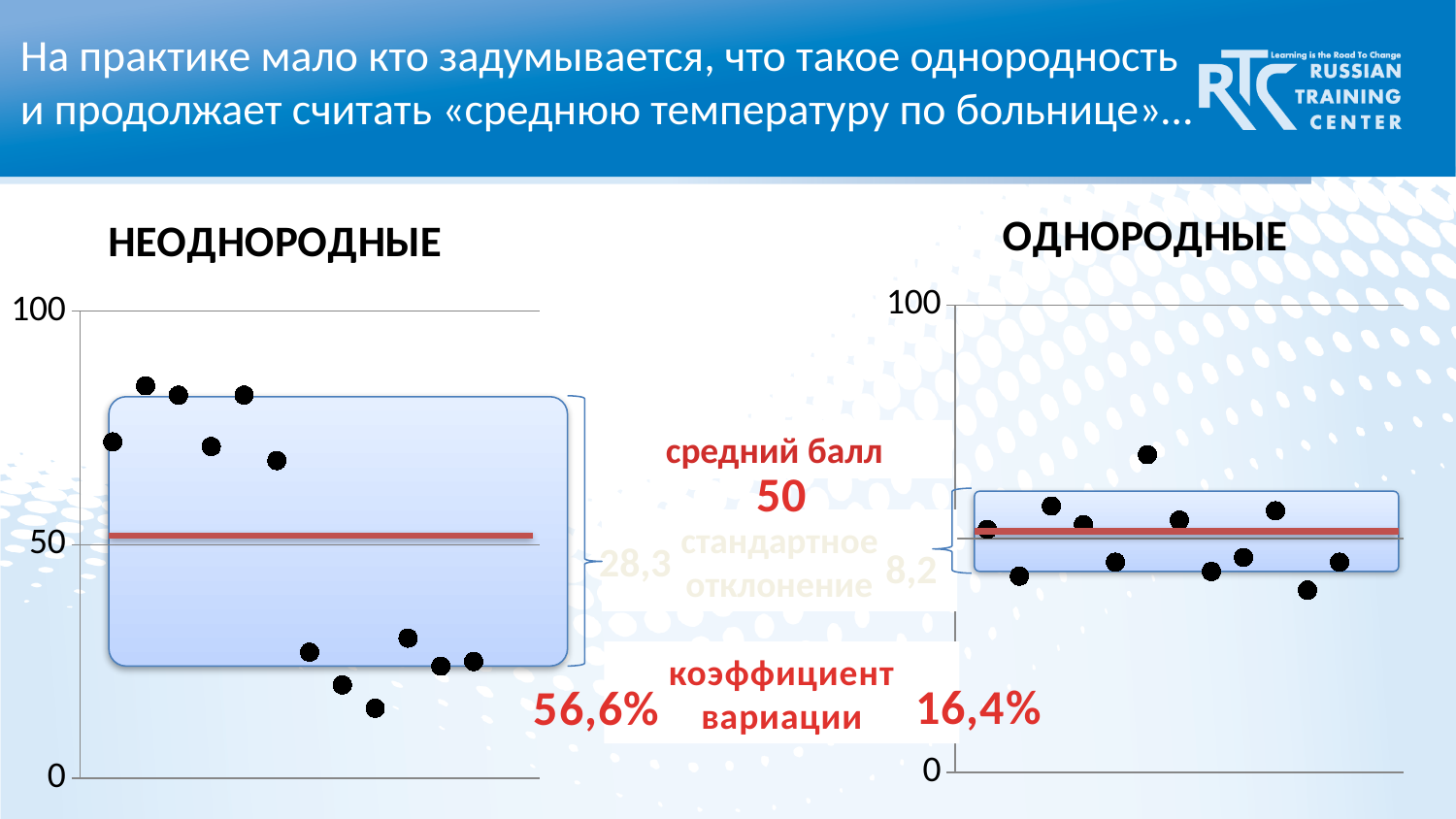
In the НЕОДНОРОДНЫЕ chart, is the lowest plotted point greater or less than 50? less What is the maximum value shown on the y axis of the НЕОДНОРОДНЫЕ chart? 100 What kind of chart is used on the slide for НЕОДНОРОДНЫЕ and ОДНОРОДНЫЕ? scatter chart In the ОДНОРОДНЫЕ chart, is the highest plotted point greater or less than 50? greater What стандартное отклонение is shown for the ОДНОРОДНЫЕ chart? 8,2 What is the коэффициент вариации shown for the ОДНОРОДНЫЕ chart? 16,4% What is the difference between the коэффициент вариации of the НЕОДНОРОДНЫЕ chart and that of the ОДНОРОДНЫЕ chart? 40,2 percentage points Which chart has the larger коэффициент вариации, НЕОДНОРОДНЫЕ or ОДНОРОДНЫЕ? НЕОДНОРОДНЫЕ What is the title of the chart on the left side of the slide? НЕОДНОРОДНЫЕ What средний балл is shown between the two charts? 50 What стандартное отклонение is shown for the НЕОДНОРОДНЫЕ chart? 28,3 What is the коэффициент вариации shown for the НЕОДНОРОДНЫЕ chart? 56,6%